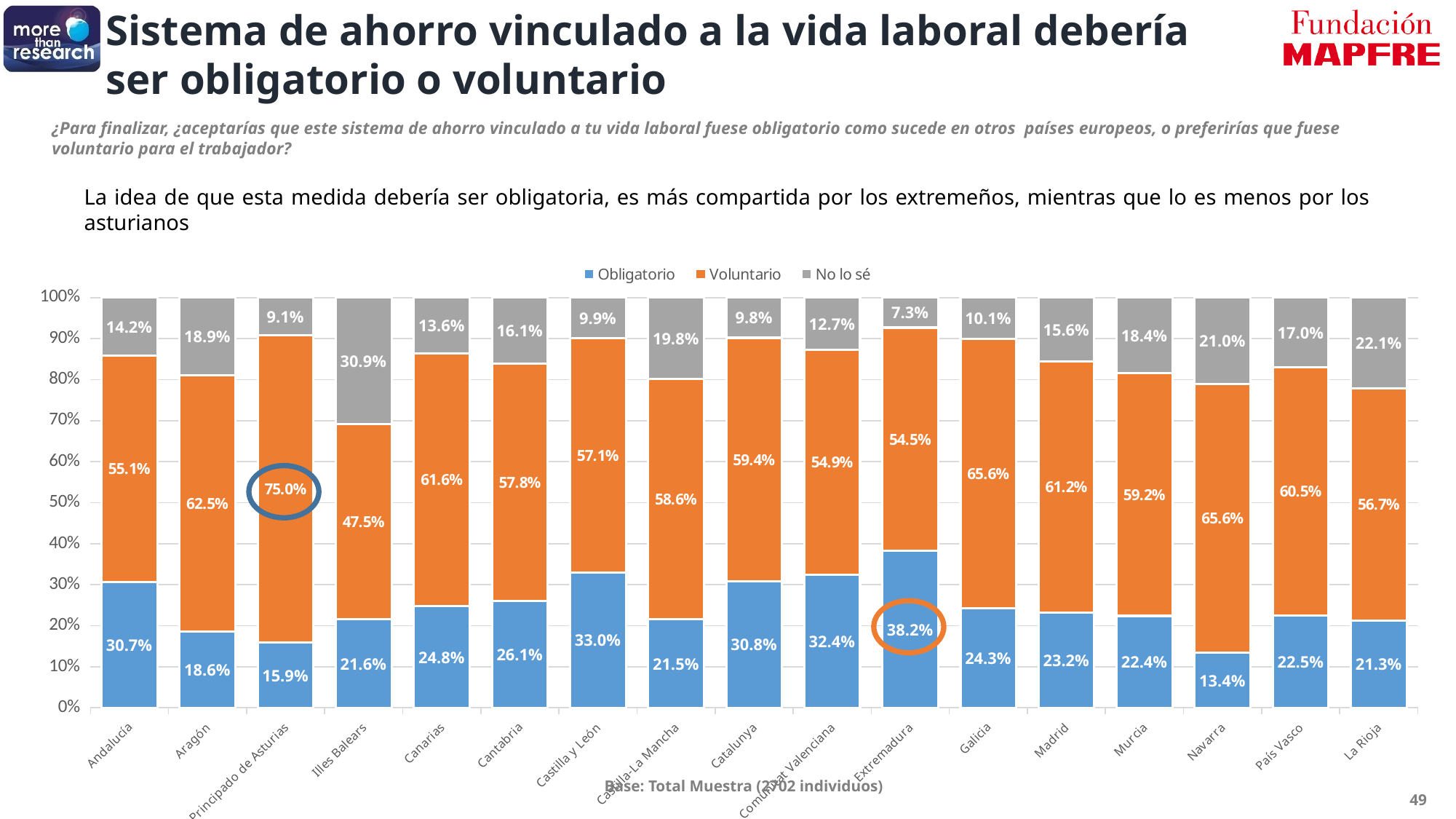
Which region has the lowest "Voluntario" percentage? Illes Balears What kind of chart is shown on the slide? Stacked bar chart Which region has the highest "Obligatorio" percentage? Extremadura Which region has the lowest "Obligatorio" percentage? Navarra Which is larger, the "Obligatorio" value for Castilla y León or for Catalunya? Castilla y León How many regions are shown on the x axis? 17 What is the "Voluntario" value for Principado de Asturias? 75.0% What is the difference in percentage points between the "Obligatorio" values for Extremadura and Navarra? 24.8 percentage points What percentage of respondents in Extremadura chose "Obligatorio"? 38.2% How many series does the legend list? 3 Which region has the lowest "No lo sé" percentage? Extremadura What is the "No lo sé" value for Illes Balears? 30.9%